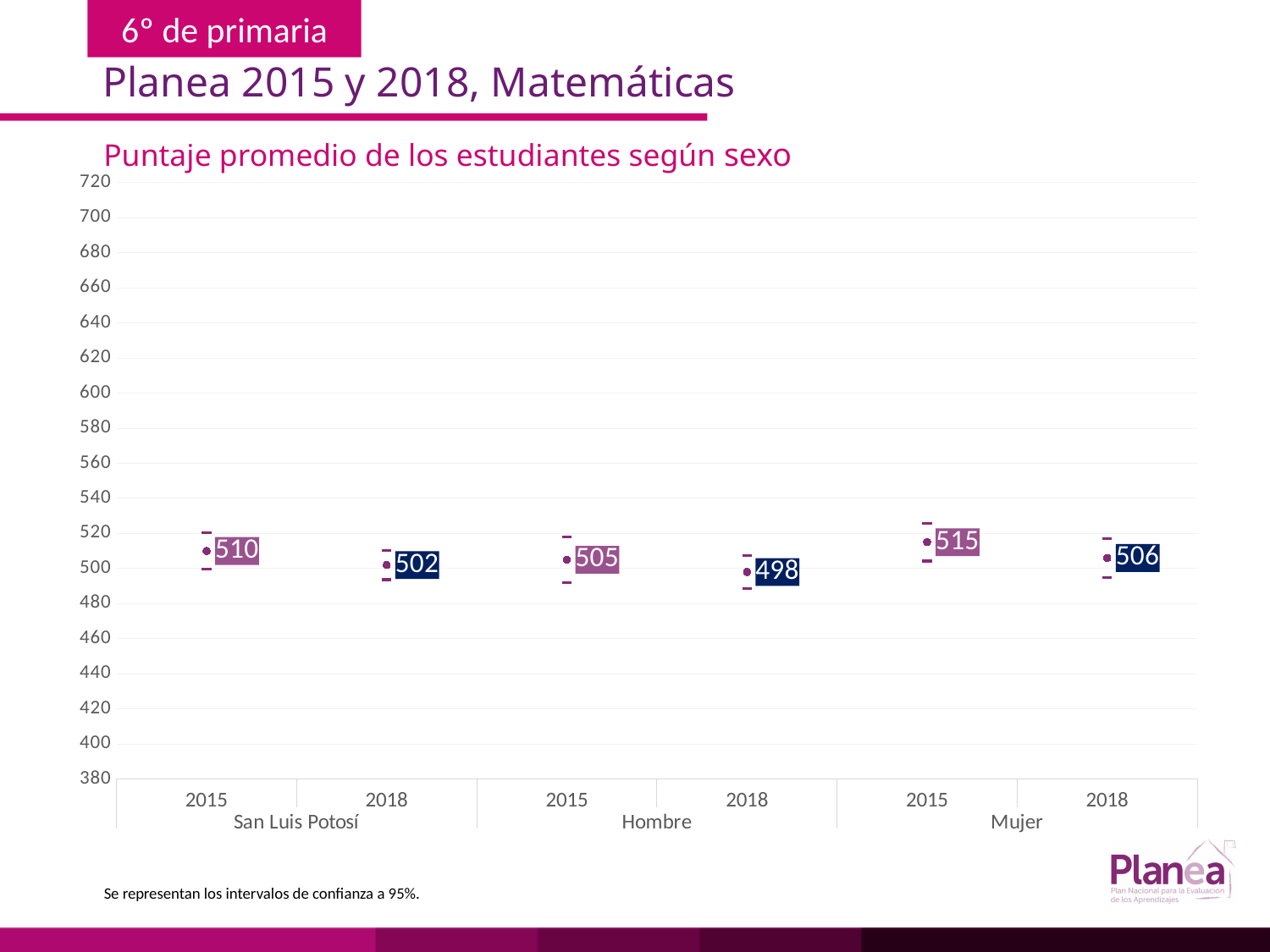
Which is larger, the Hombre score in 2015 or the Mujer score in 2015? Mujer 2015 What is the average score for Hombre in 2018? 498 How many data points are plotted on the chart? 6 What is the average score for Mujer in 2015? 515 Which group and year has the highest average score? Mujer 2015 What is the average score for San Luis Potosí in 2015? 510 What is the title of the chart? Puntaje promedio de los estudiantes según sexo What is the difference between the Hombre score in 2015 and in 2018? 7 What is the average score for Mujer in 2018? 506 What is the difference between the Mujer score in 2015 and in 2018? 9 Which group and year has the lowest average score? Hombre 2018 Did the San Luis Potosí average score rise or fall from 2015 to 2018? fall